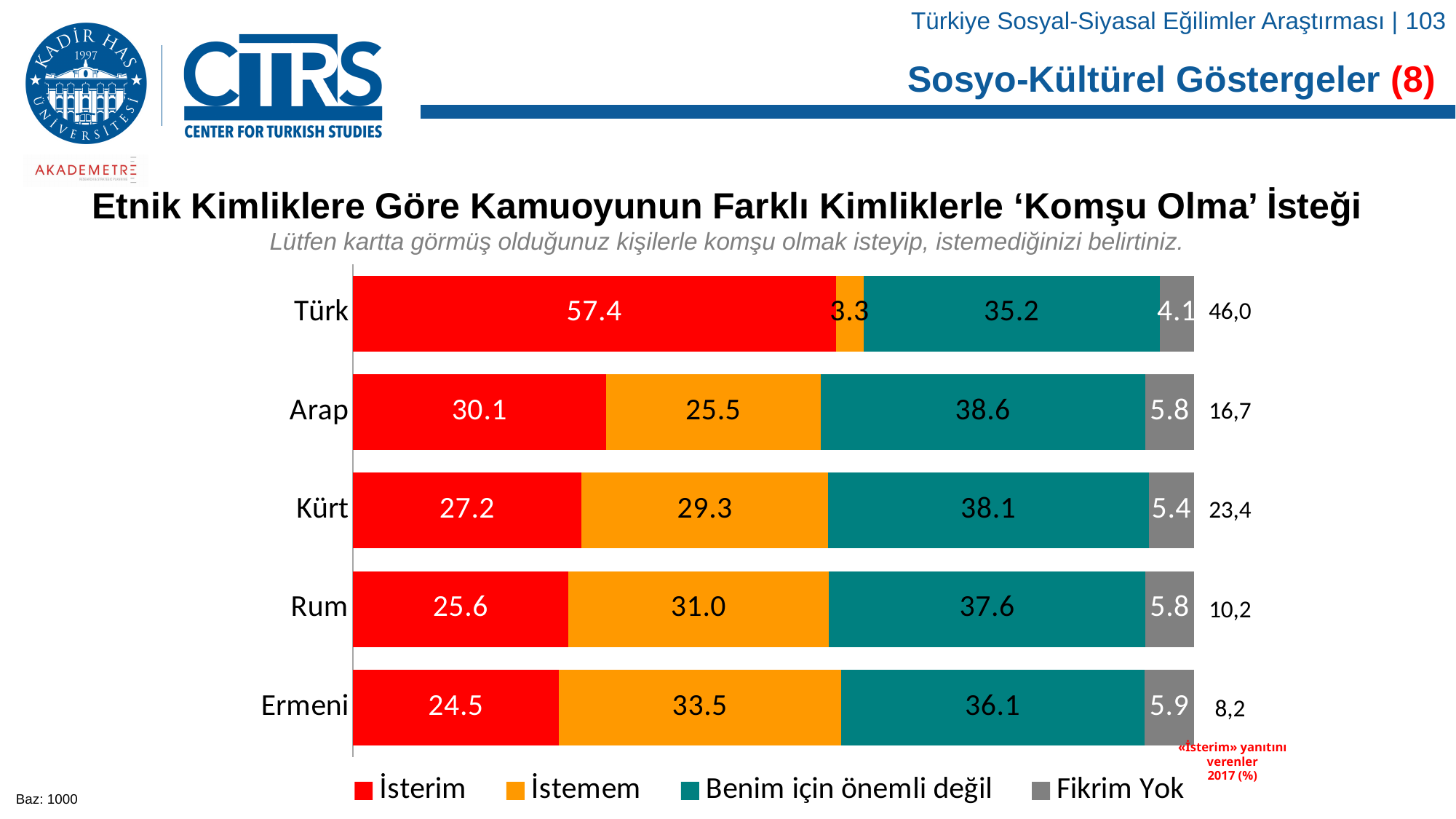
Which category has the lowest 'İstemem' value? Türk Which category has the highest 'İsterim' value? Türk What kind of chart is shown on the slide? Stacked bar chart How many series does the chart legend list? 4 What is the 'İsterim' value for Türk? 57.4 What is the 'İstemem' value for Ermeni? 33.5 What is the 'Fikrim Yok' value for Kürt? 5.4 What is the 'Benim için önemli değil' value for Arap? 38.6 What is the 2017 'İsterim' percentage shown to the right of the bar for Ermeni? 8,2 Which is larger, the 'İstemem' value for Rum or for Kürt? Rum What is the difference between the 'İsterim' values for Arap and Kürt? 2.9 How many ethnic identity categories are plotted in the chart? 5